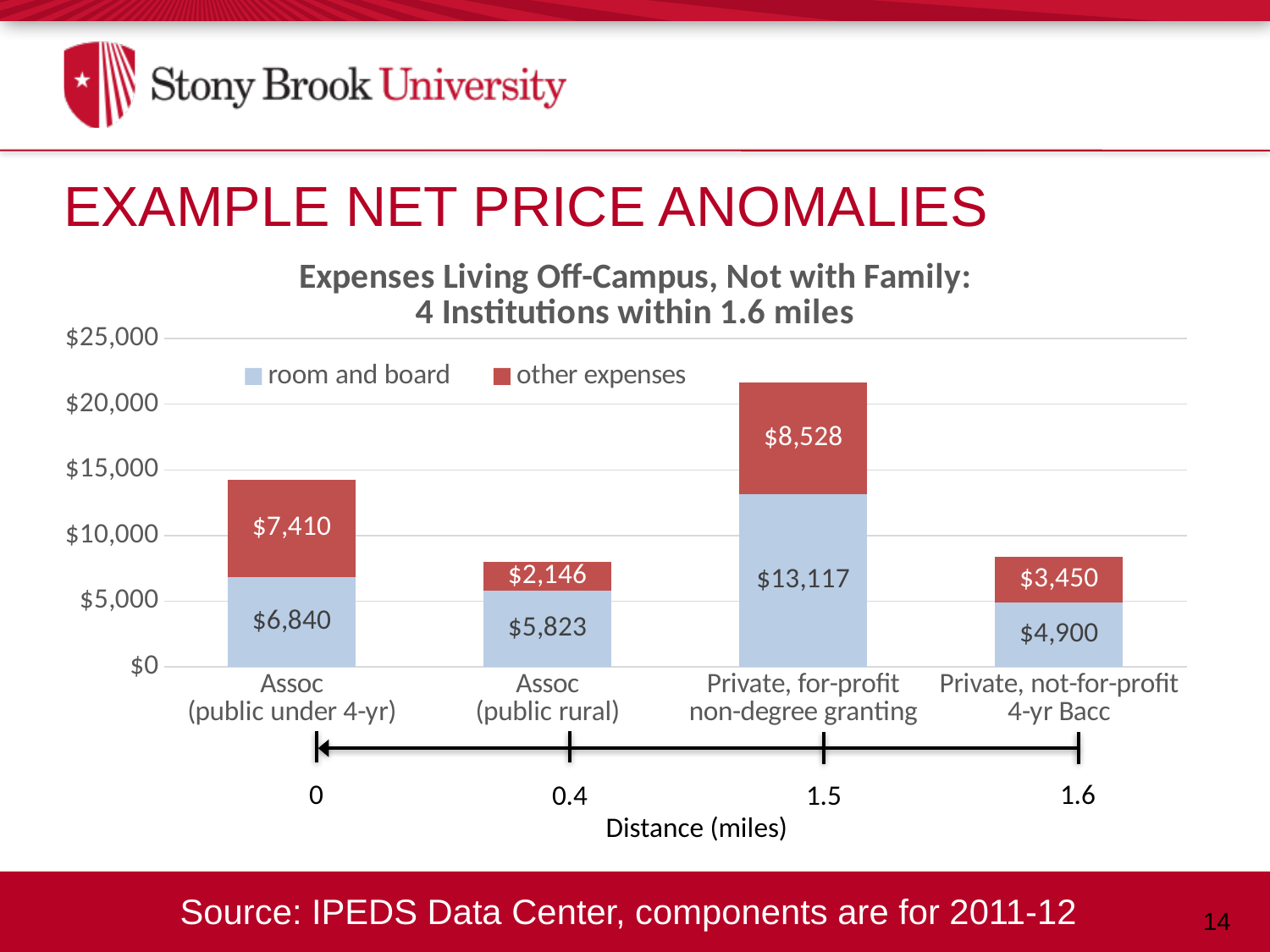
What is the room and board value for Assoc (public under 4-yr)? $6,840 What type of chart is shown? Stacked bar chart How many series does the legend list? 2 What is the difference between the other expenses values for Assoc (public under 4-yr) and Assoc (public rural)? $5,264 Which category has the highest room and board value? Private, for-profit non-degree granting What is the total of the stacked bar for Assoc (public rural)? $7,969 Which is larger: room and board for Assoc (public rural) or room and board for Private, not-for-profit 4-yr Bacc? Assoc (public rural) What is the room and board value for Private, not-for-profit 4-yr Bacc? $4,900 What is the total of the stacked bar for Private, for-profit non-degree granting? $21,645 How many categories are shown on the x axis? 4 What is the other expenses value for Private, for-profit non-degree granting? $8,528 Which category has the lowest other expenses value? Assoc (public rural)